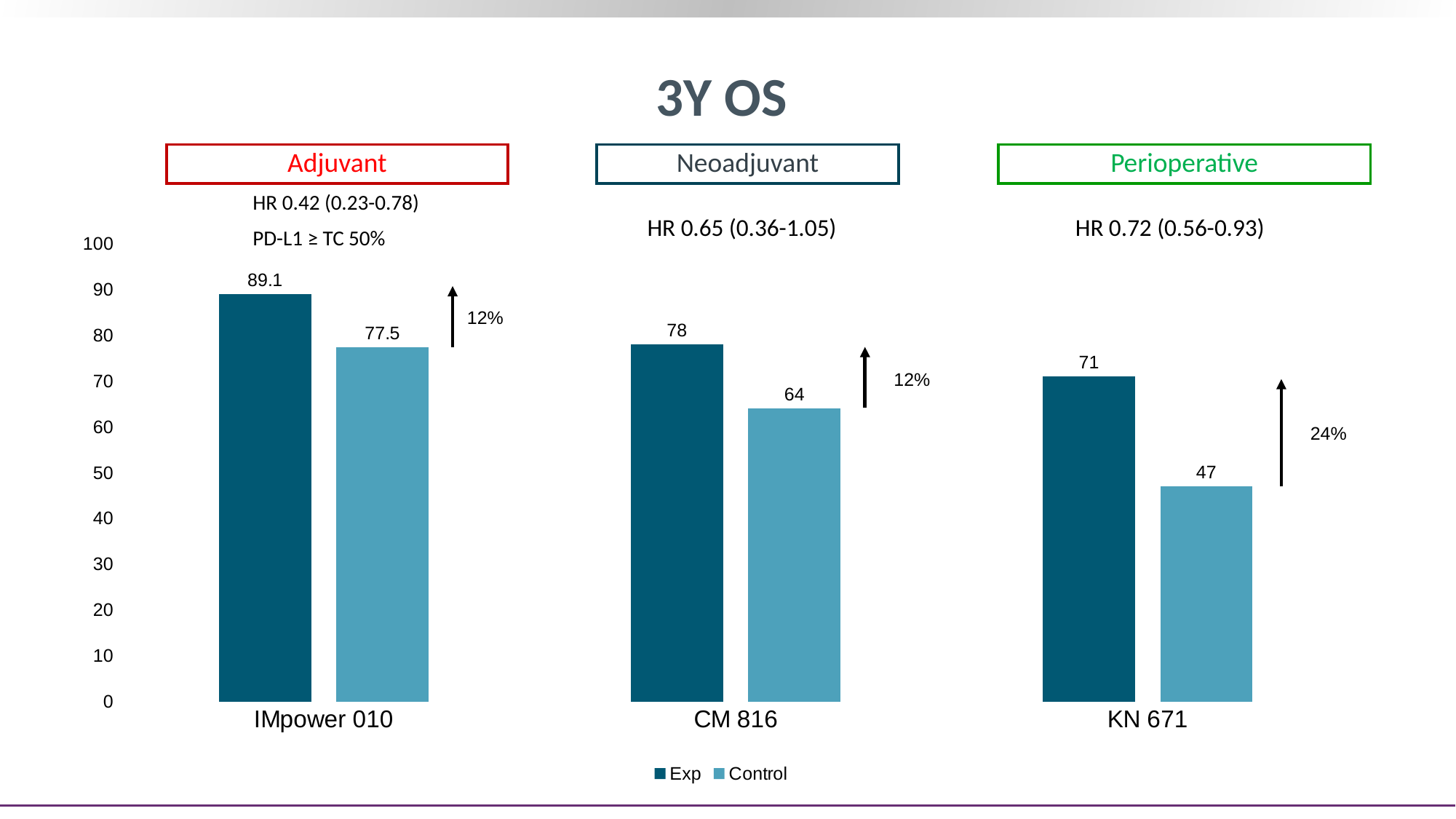
What is the Exp value for IMpower 010? 89.1 What is the Control value for KN 671? 47 What type of chart is shown on the slide? Bar chart Which trial has the lowest Control value? KN 671 How many trials are shown on the x axis? 3 What is the Exp value for CM 816? 78 How many series does the legend list? 2 Which is larger for IMpower 010, the Exp value or the Control value? Exp What is the difference between the Exp and Control values for CM 816? 14 What is the difference between the Exp and Control values for KN 671? 24 Which trial has the highest Exp value? IMpower 010 What is the Control value for CM 816? 64